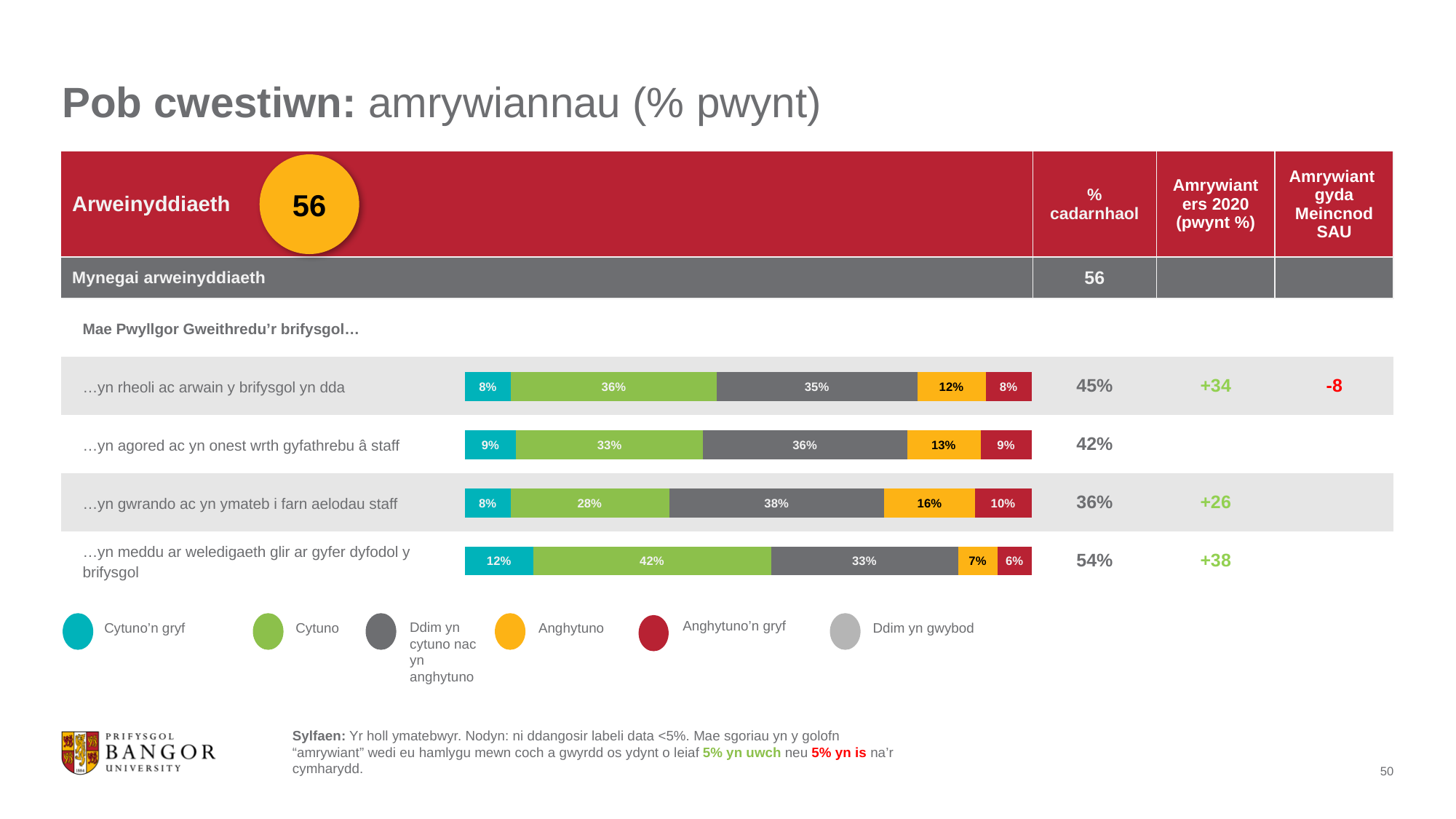
Which has a larger 'Anghytuno' percentage: '…yn rheoli ac arwain y brifysgol yn dda' or '…yn gwrando ac yn ymateb i farn aelodau staff'? …yn gwrando ac yn ymateb i farn aelodau staff What is the 'Anghytuno'n gryf' percentage for '…yn agored ac yn onest wrth gyfathrebu â staff'? 9% Which statement has the highest '% cadarnhaol' value? …yn meddu ar weledigaeth glir ar gyfer dyfodol y brifysgol How many statements (bars) are plotted in the chart? 4 Which colour represents 'Cytuno'n gryf' in the legend? Teal What type of chart is used to show the responses for each statement? Stacked bar chart How many response categories does the legend list? 6 What is the 'Ddim yn cytuno nac yn anghytuno' percentage for '…yn gwrando ac yn ymateb i farn aelodau staff'? 38% What is the 'Amrywiant ers 2020 (pwynt %)' value for '…yn rheoli ac arwain y brifysgol yn dda'? +34 What is the difference in 'Cytuno' percentage between '…yn meddu ar weledigaeth glir ar gyfer dyfodol y brifysgol' and '…yn gwrando ac yn ymateb i farn aelodau staff'? 14 percentage points What is the 'Cytuno' (agree) percentage for '…yn meddu ar weledigaeth glir ar gyfer dyfodol y brifysgol'? 42% Which statement has the lowest '% cadarnhaol' value? …yn gwrando ac yn ymateb i farn aelodau staff